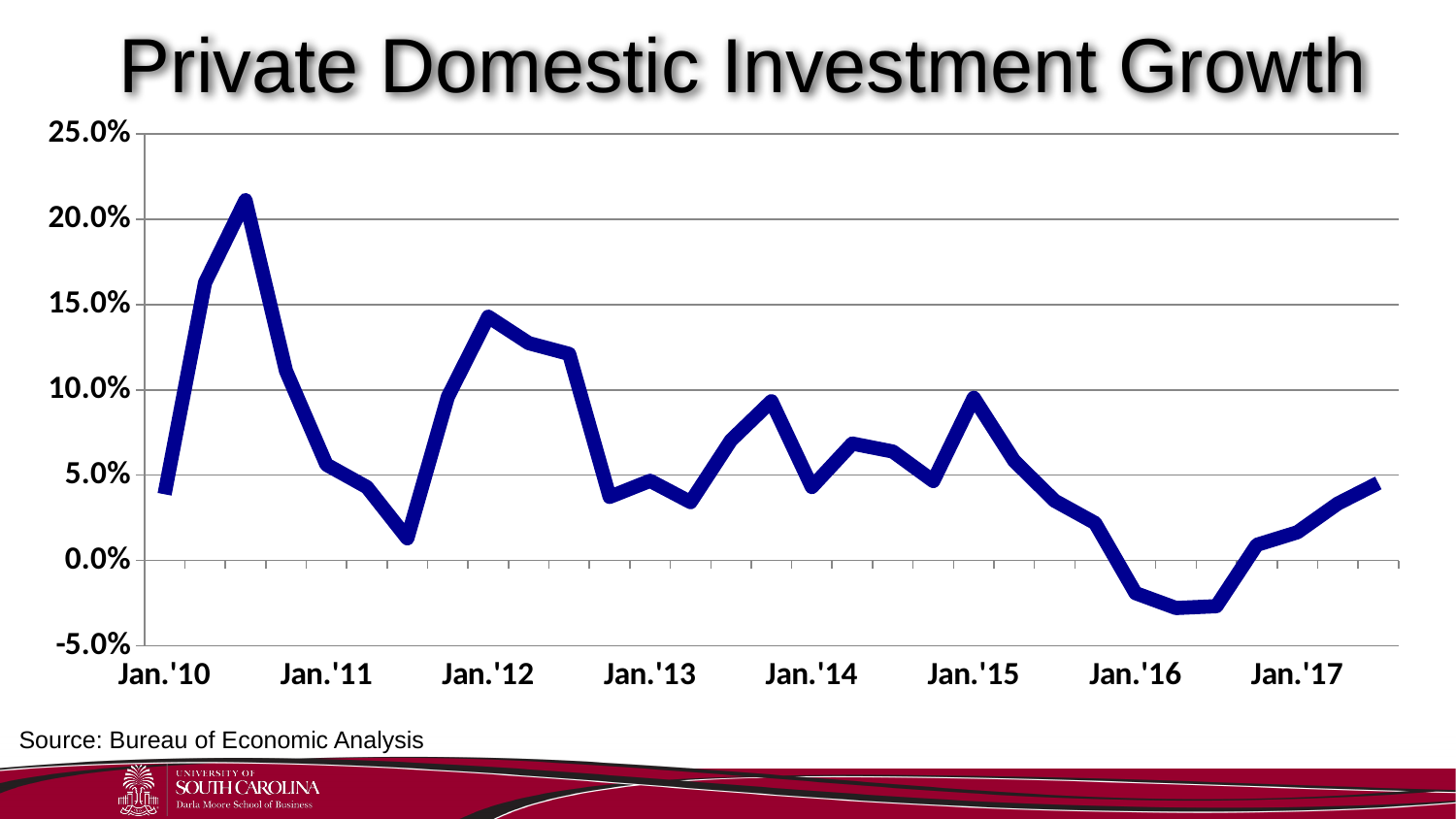
Which is larger, the value at Jan.'12 or the value at Jan.'13? Jan.'12 Is the highest point on the line greater or less than 20.0%? greater What kind of chart is shown on the slide? line chart Is the value at Jan.'12 greater or less than 10.0%? greater What source is cited for the chart? Bureau of Economic Analysis Is the value at Jan.'16 greater or less than 0.0%? less How many year labels are shown on the x axis? 8 Does the line rise or fall between Jan.'16 and Jan.'17? rise Does the line rise or fall between Jan.'15 and Jan.'16? fall What is the title of the chart? Private Domestic Investment Growth